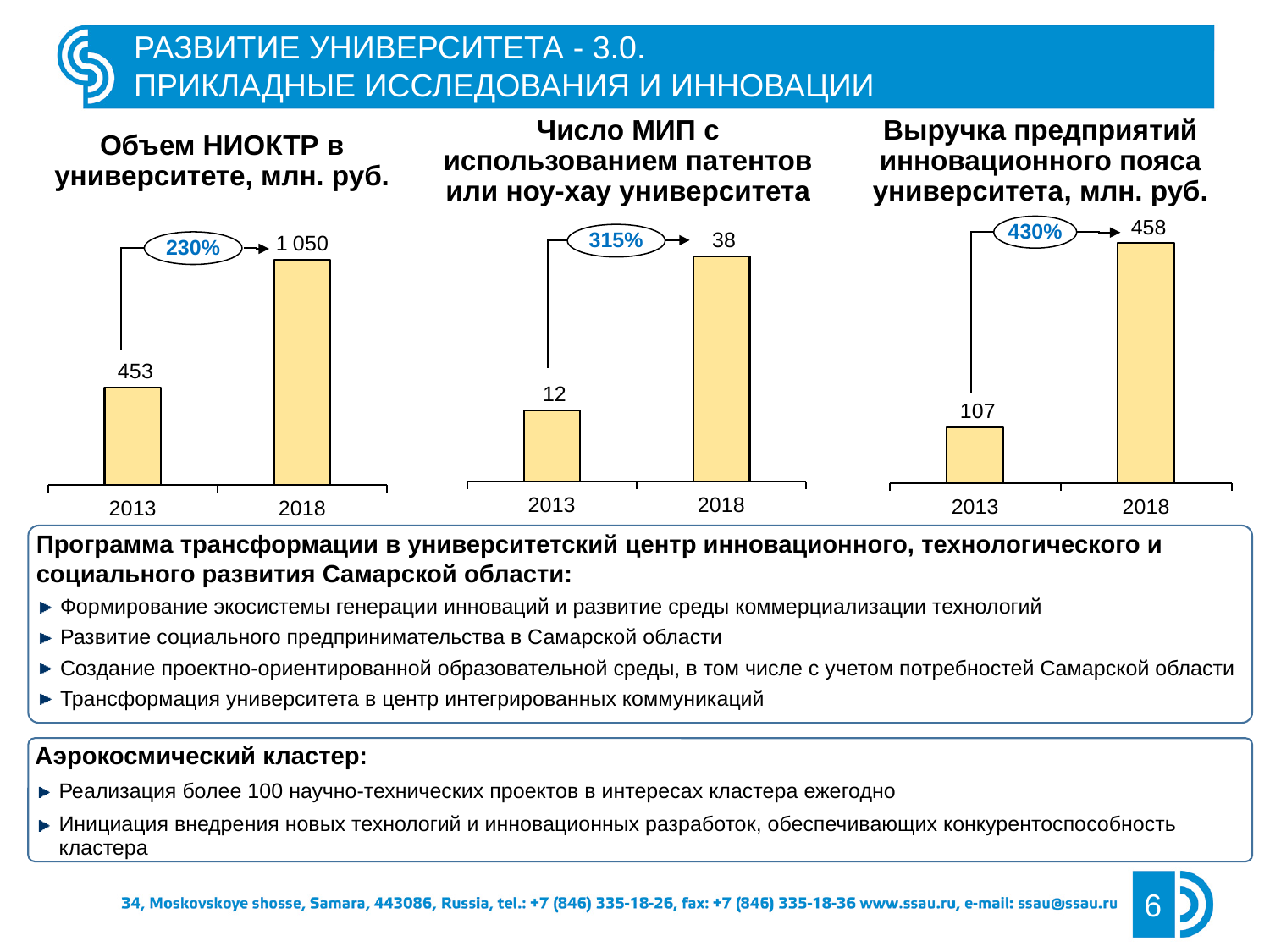
What type of chart is the middle chart 'Число МИП с использованием патентов или ноу-хау университета'? bar chart In the middle chart 'Число МИП с использованием патентов или ноу-хау университета', what is the value for 2018? 38 In the middle chart 'Число МИП с использованием патентов или ноу-хау университета', which year has the lowest value? 2013 In the right chart 'Выручка предприятий инновационного пояса университета, млн. руб.', do the values rise or fall from 2013 to 2018? rise How many bars are shown in the left chart 'Объем НИОКТР в университете, млн. руб.'? 2 In the right chart 'Выручка предприятий инновационного пояса университета, млн. руб.', what is the difference between the 2018 and 2013 values? 351 In the left chart 'Объем НИОКТР в университете, млн. руб.', which year has the higher value? 2018 In the left chart 'Объем НИОКТР в университете, млн. руб.', what is the value for 2013? 453 In the right chart 'Выручка предприятий инновационного пояса университета, млн. руб.', what is the value for 2013? 107 In the middle chart 'Число МИП с использованием патентов или ноу-хау университета', what is the difference between the 2018 and 2013 values? 26 What growth percentage is shown in the annotation on the right chart 'Выручка предприятий инновационного пояса университета, млн. руб.'? 430% In the left chart 'Объем НИОКТР в университете, млн. руб.', what is the value for 2018? 1 050